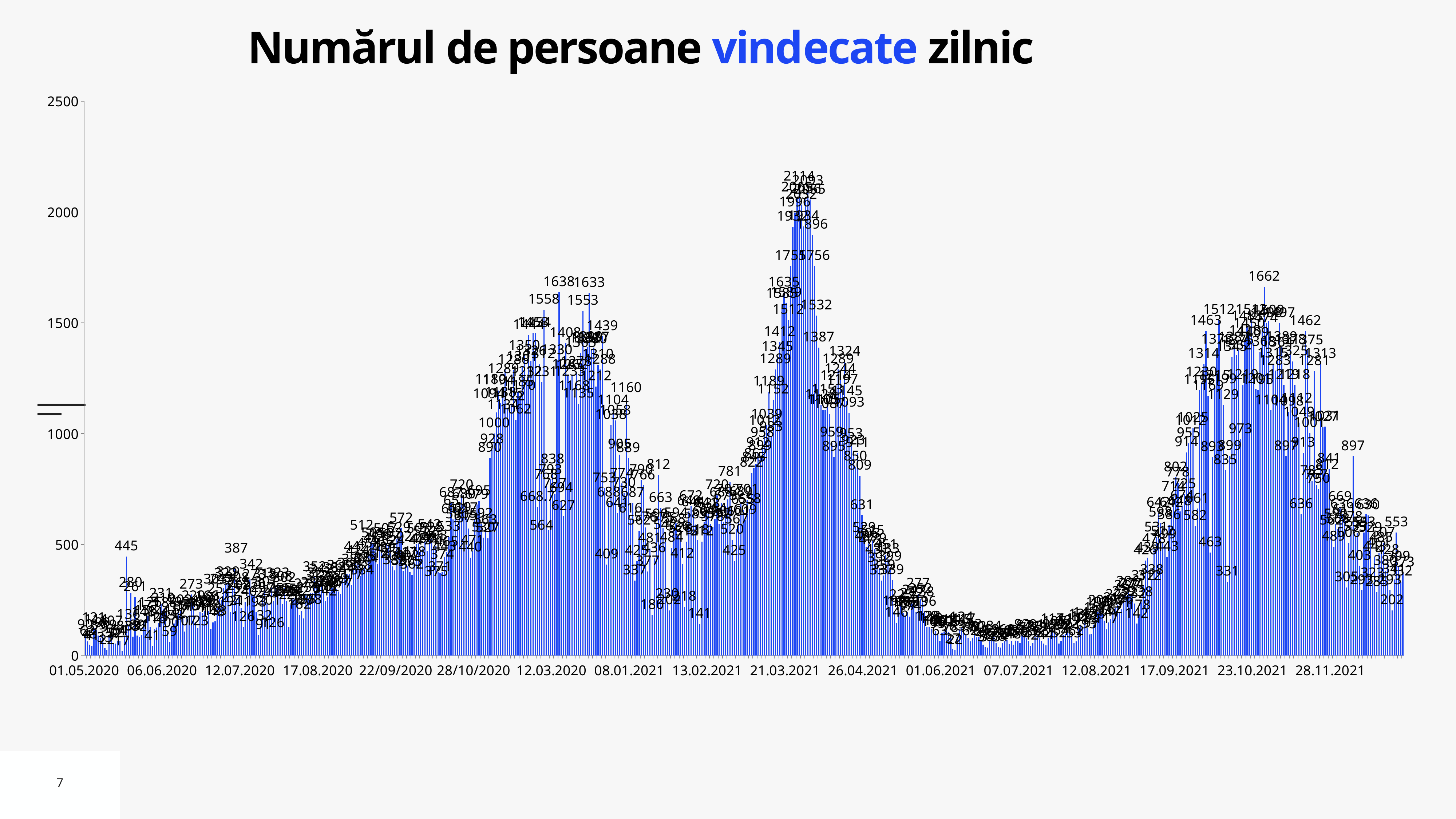
What kind of chart is shown on the slide? bar chart Do the values rise or fall along the x axis between 26.04.2021 and 01.06.2021? fall What is the highest value labelled on the peak near 23.10.2021? 1662 What is the difference between the highest labelled value near 21.03.2021 (2114) and the highest labelled value near 23.10.2021 (1662)? 452 Do the values rise or fall along the x axis between 12.08.2021 and 23.10.2021? rise What is the highest value shown on the y axis? 2500 Which peak is higher: the one near 21.03.2021 or the one near 23.10.2021? the one near 21.03.2021 Are the values around 07.07.2021 greater or less than 500? less Is the highest value near 21.03.2021 greater or less than 2000? greater How many date labels are shown on the x axis? 17 What is the title of the chart? Numărul de persoane vindecate zilnic What is the highest data label printed on the chart? 2114